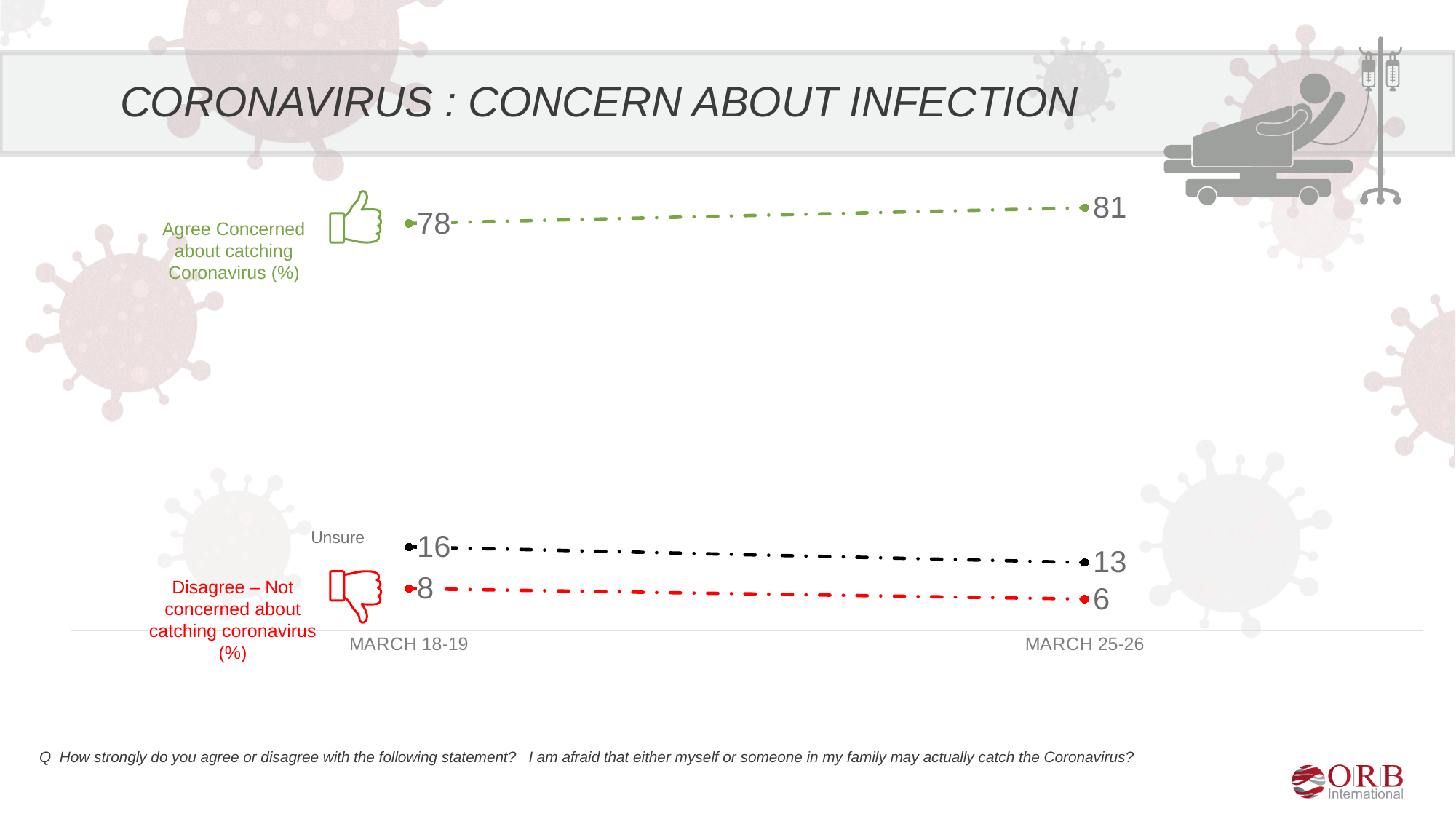
How many time points are shown on the x axis? 2 Which series has the lowest value on March 18-19? Disagree – Not concerned about catching coronavirus (%) What is the value for 'Agree Concerned about catching Coronavirus (%)' on March 18-19? 78 Which series has the highest value on March 25-26? Agree Concerned about catching Coronavirus (%) What type of chart is shown on the slide? line chart By how much did the 'Agree Concerned about catching Coronavirus (%)' value change from March 18-19 to March 25-26? 3 What is the difference between the 'Unsure' and 'Disagree' values on March 18-19? 8 What is the value for 'Unsure' on March 18-19? 16 Which is larger on March 25-26: the 'Unsure' value or the 'Disagree' value? Unsure What is the value for 'Disagree – Not concerned about catching coronavirus (%)' on March 25-26? 6 Does the 'Unsure' series rise or fall from March 18-19 to March 25-26? fall What is the value for 'Agree Concerned about catching Coronavirus (%)' on March 25-26? 81